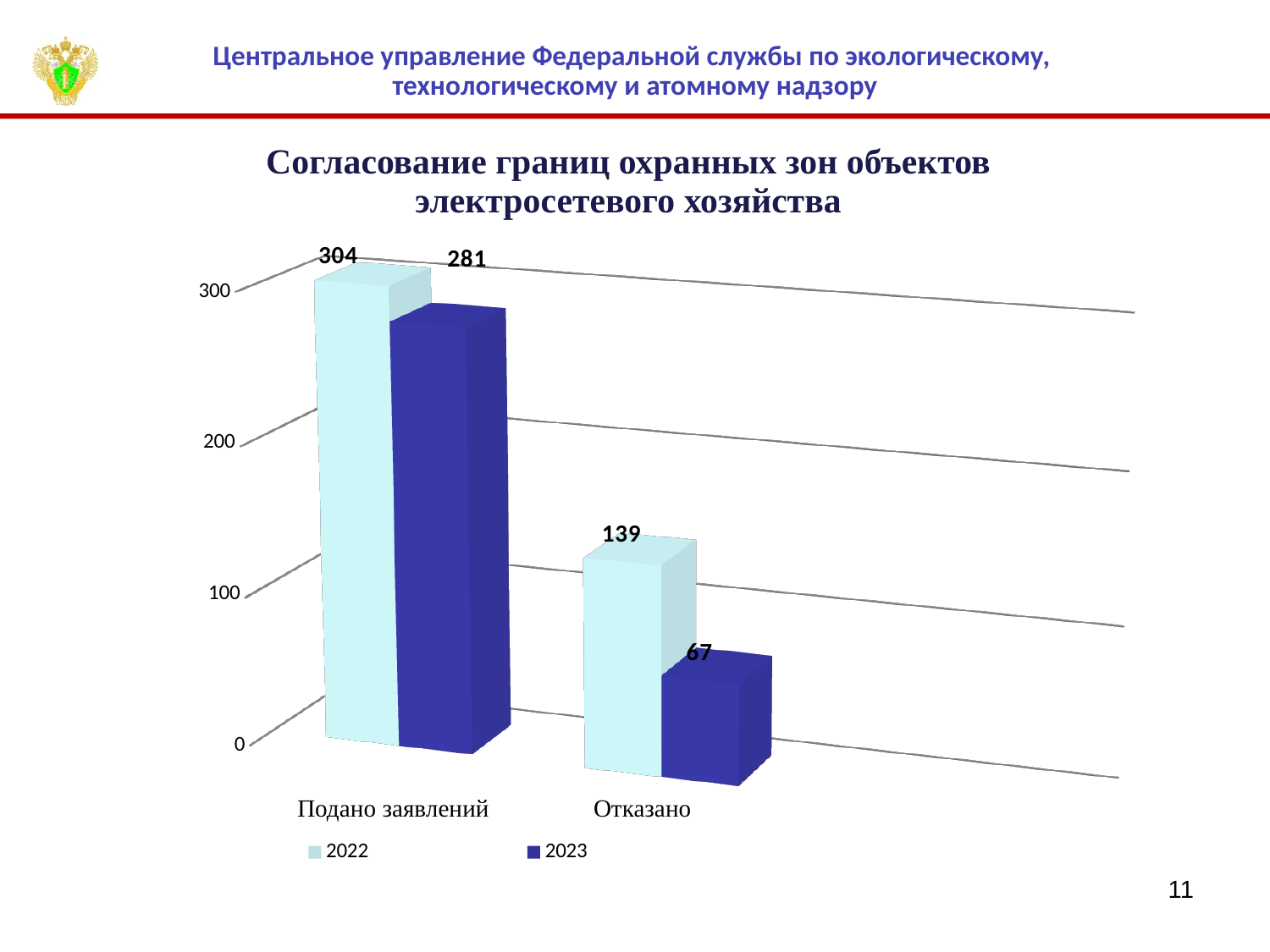
What is the value for 2022 in the 'Подано заявлений' category? 304 What is the value for 2023 in the 'Отказано' category? 67 How many categories are shown on the x axis? 2 What is the value for 2023 in the 'Подано заявлений' category? 281 Which category has the lowest value for the 2023 series? Отказано Which category has the highest value for the 2022 series? Подано заявлений What kind of chart is shown on the slide? Bar chart What is the value for 2022 in the 'Отказано' category? 139 Which is larger for 'Отказано': the 2022 value or the 2023 value? 2022 What is the difference between the 2022 and 2023 values for 'Отказано'? 72 How many series does the legend list? 2 What is the difference between the 2022 and 2023 values for 'Подано заявлений'? 23